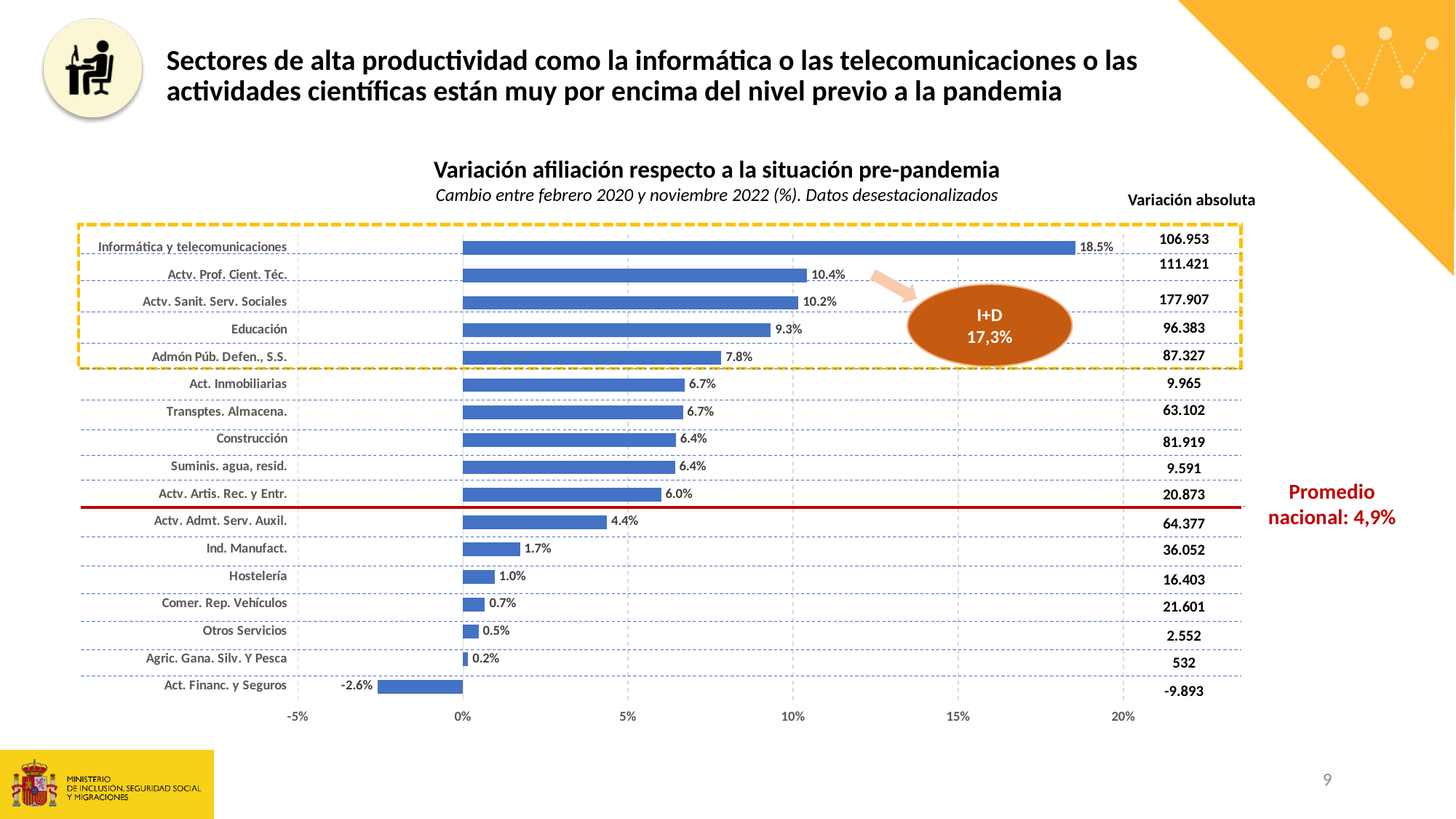
What is the value shown for Educación? 9.3% What is the value shown for Act. Financ. y Seguros? -2.6% What is the difference between the values for Informática y telecomunicaciones and Actv. Prof. Cient. Téc.? 8.1 percentage points Is the value for Actv. Admt. Serv. Auxil. greater or less than 5%? less Which category has the lowest value in the chart? Act. Financ. y Seguros Which is larger, the value for Educación or the value for Admón Púb. Defen., S.S.? Educación Which category has the highest value in the chart? Informática y telecomunicaciones What is the title of the chart? Variación afiliación respecto a la situación pre-pandemia What is the value shown for Informática y telecomunicaciones? 18.5% What is the value shown for Hostelería? 1.0% How many categories are plotted in the chart? 17 What kind of chart is shown on the slide? Bar chart